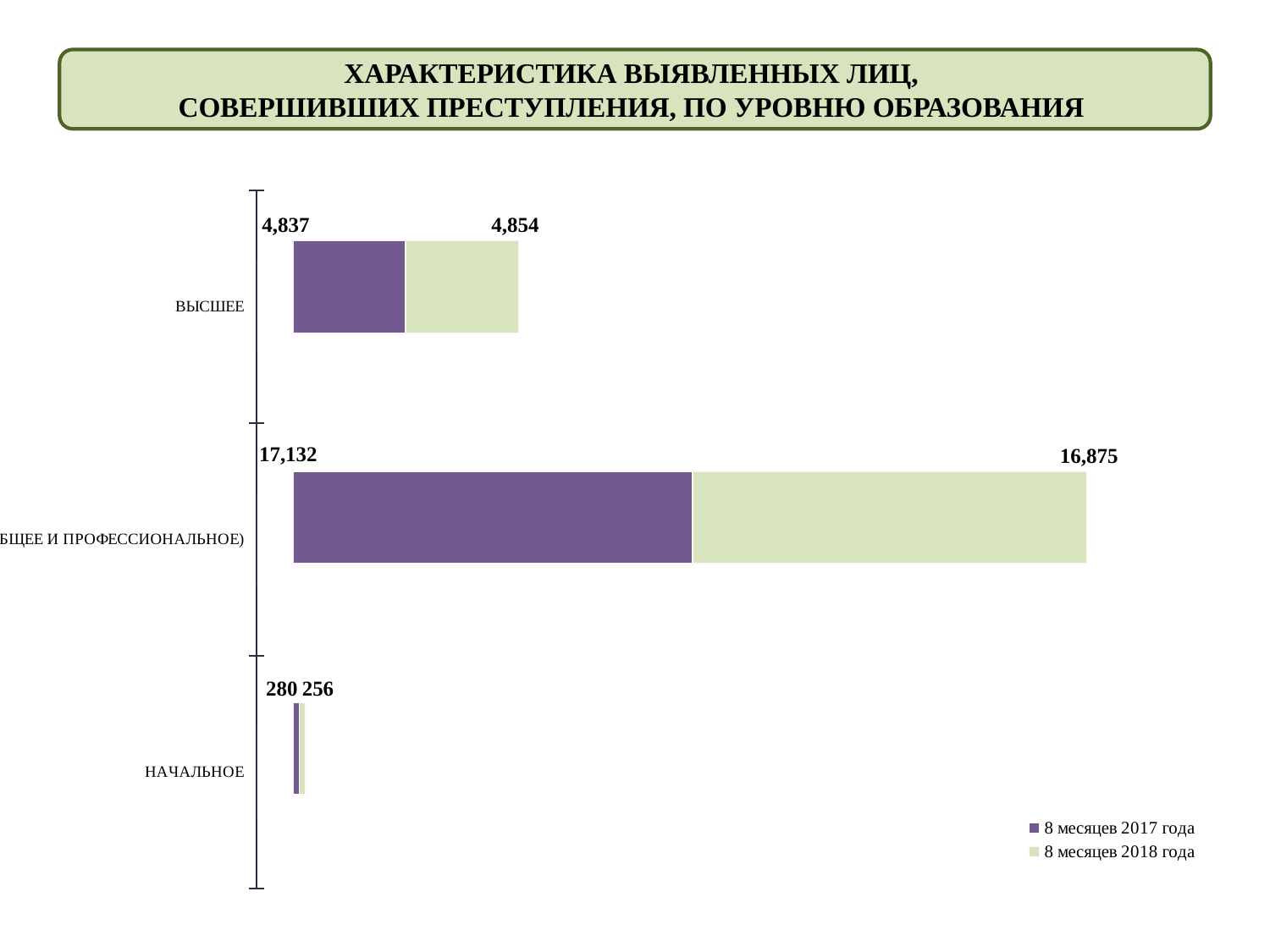
For ВЫСШЕЕ, which series has the larger value, 8 месяцев 2017 года or 8 месяцев 2018 года? 8 месяцев 2018 года What is the total of the stacked bar for НАЧАЛЬНОЕ? 536 What is the difference between the 8 месяцев 2018 года and 8 месяцев 2017 года values for ВЫСШЕЕ? 17 What is the value for НАЧАЛЬНОЕ in the series 8 месяцев 2018 года? 256 What is the value for ВЫСШЕЕ in the series 8 месяцев 2018 года? 4,854 How many series does the legend list? 2 What is the value for ВЫСШЕЕ in the series 8 месяцев 2017 года? 4,837 What is the total of the stacked bar for ВЫСШЕЕ? 9,691 What is the difference between the 8 месяцев 2017 года and 8 месяцев 2018 года values for НАЧАЛЬНОЕ? 24 What kind of chart is shown on the slide? Bar chart Which category has the lowest value for 8 месяцев 2017 года? НАЧАЛЬНОЕ What is the value for НАЧАЛЬНОЕ in the series 8 месяцев 2017 года? 280